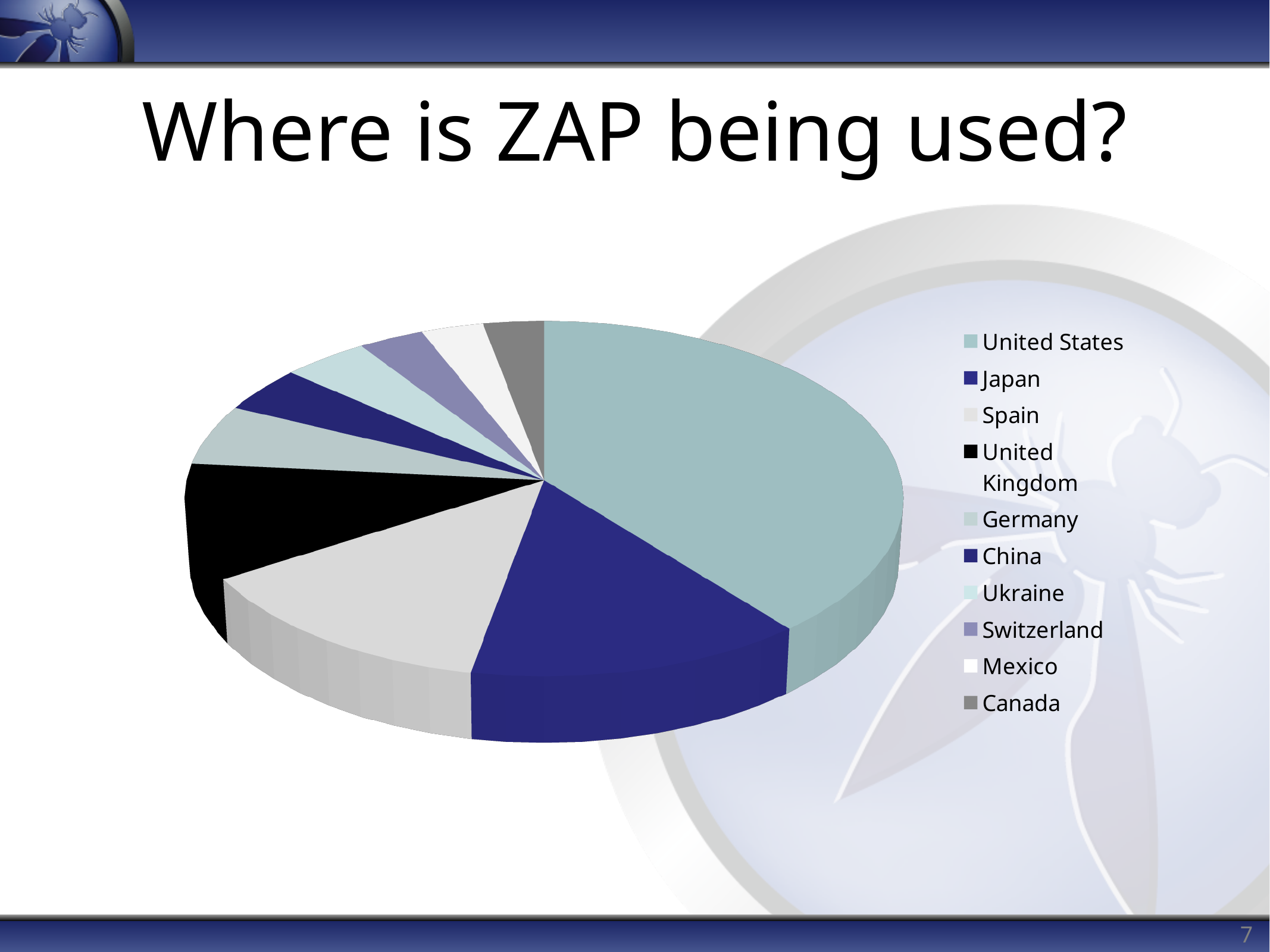
How many countries does the legend of the pie chart list? 10 Which slice is larger, United Kingdom or Mexico? United Kingdom Which slice is larger, Spain or Switzerland? Spain What is the title of the slide containing the pie chart? Where is ZAP being used? Which slice is larger, United States or Japan? United States What kind of chart is shown on the slide? pie chart Which country has the largest slice of the pie chart? United States Which country is listed first in the pie chart's legend? United States How many slices does the pie chart have? 10